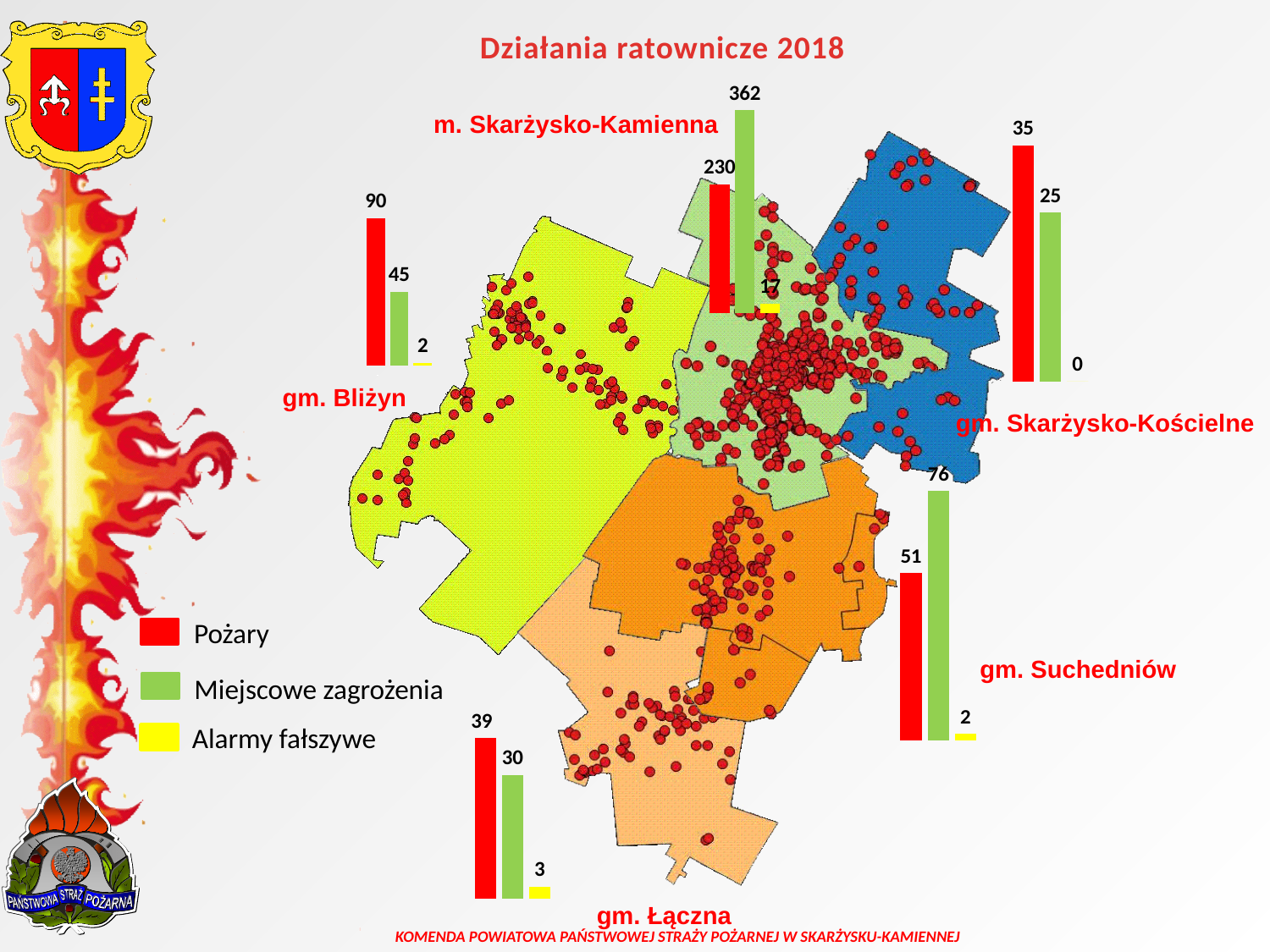
On the gm. Suchedniów chart, what is the value for Miejscowe zagrożenia? 76 On the gm. Bliżyn chart, which series has the lowest value? Alarmy fałszywe On the m. Skarżysko-Kamienna chart, what is the difference between Miejscowe zagrożenia and Pożary? 132 Which colour represents Alarmy fałszywe in the legend? Yellow On the gm. Bliżyn chart, what is the value for Pożary? 90 How many series does the legend list? 3 On the gm. Łączna chart, which series has the highest value? Pożary On the gm. Skarżysko-Kościelne chart, what is the value for Alarmy fałszywe? 0 On the gm. Skarżysko-Kościelne chart, what is the difference between Pożary and Miejscowe zagrożenia? 10 On the gm. Suchedniów chart, which is larger, Pożary or Miejscowe zagrożenia? Miejscowe zagrożenia On the m. Skarżysko-Kamienna chart, what is the value for Miejscowe zagrożenia? 362 What kind of chart is used for each municipality on the slide? Bar chart